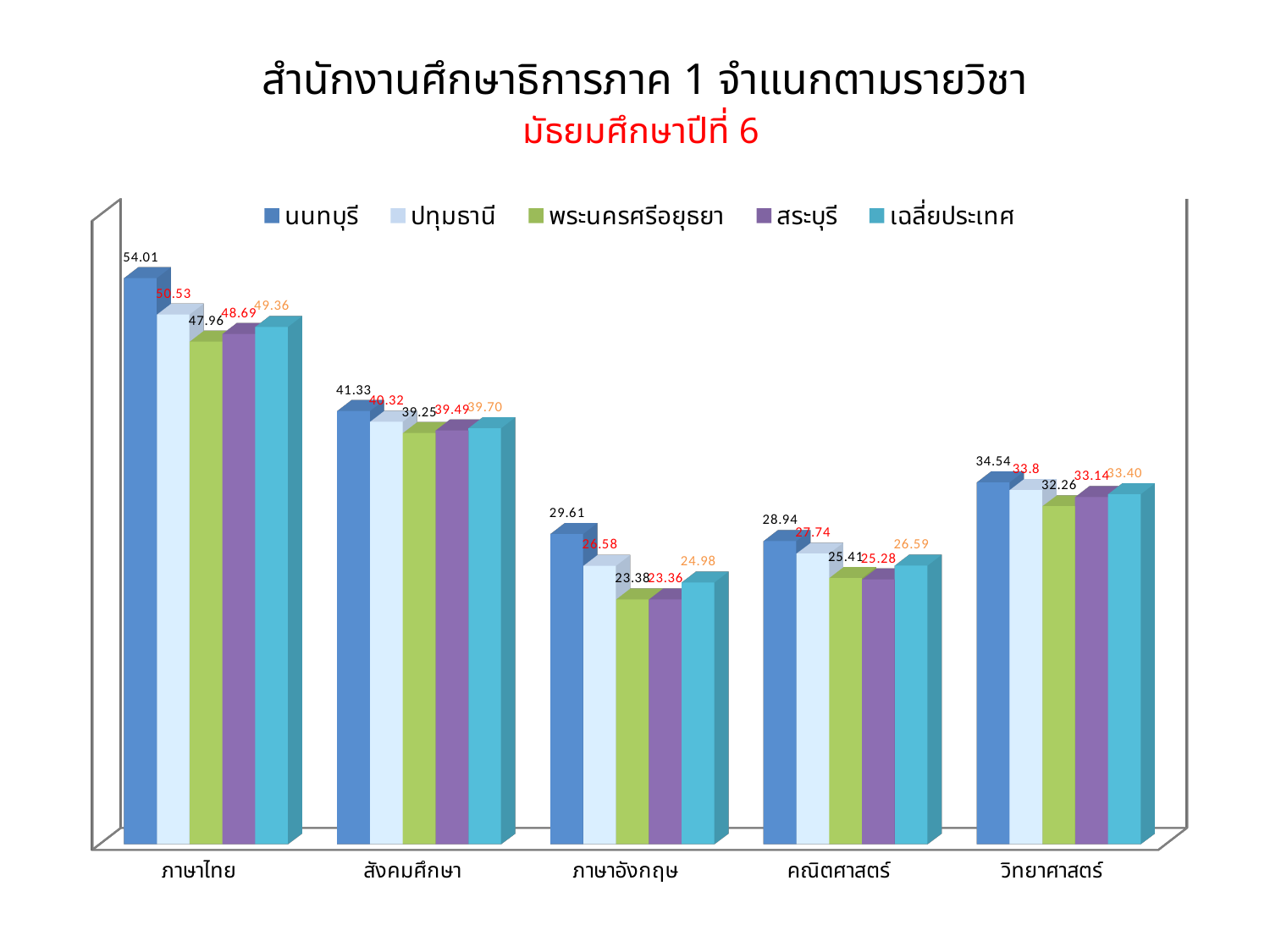
How many subjects are shown on the x axis? 5 Which is larger in สังคมศึกษา: the value for สระบุรี or the value for พระนครศรีอยุธยา? สระบุรี What is the value for พระนครศรีอยุธยา in วิทยาศาสตร์? 32.26 What is the value for สระบุรี in ภาษาอังกฤษ? 23.36 What is the difference between นนทบุรี and ปทุมธานี in ภาษาไทย? 3.48 What is the value for นนทบุรี in ภาษาไทย? 54.01 What is the value for เฉลี่ยประเทศ in คณิตศาสตร์? 26.59 Which subject has the lowest value for ปทุมธานี? ภาษาอังกฤษ Which series is shown in green in the legend? พระนครศรีอยุธยา Which subject has the highest value for นนทบุรี? ภาษาไทย How many series does the legend list? 5 What kind of chart is shown on the slide? Bar chart